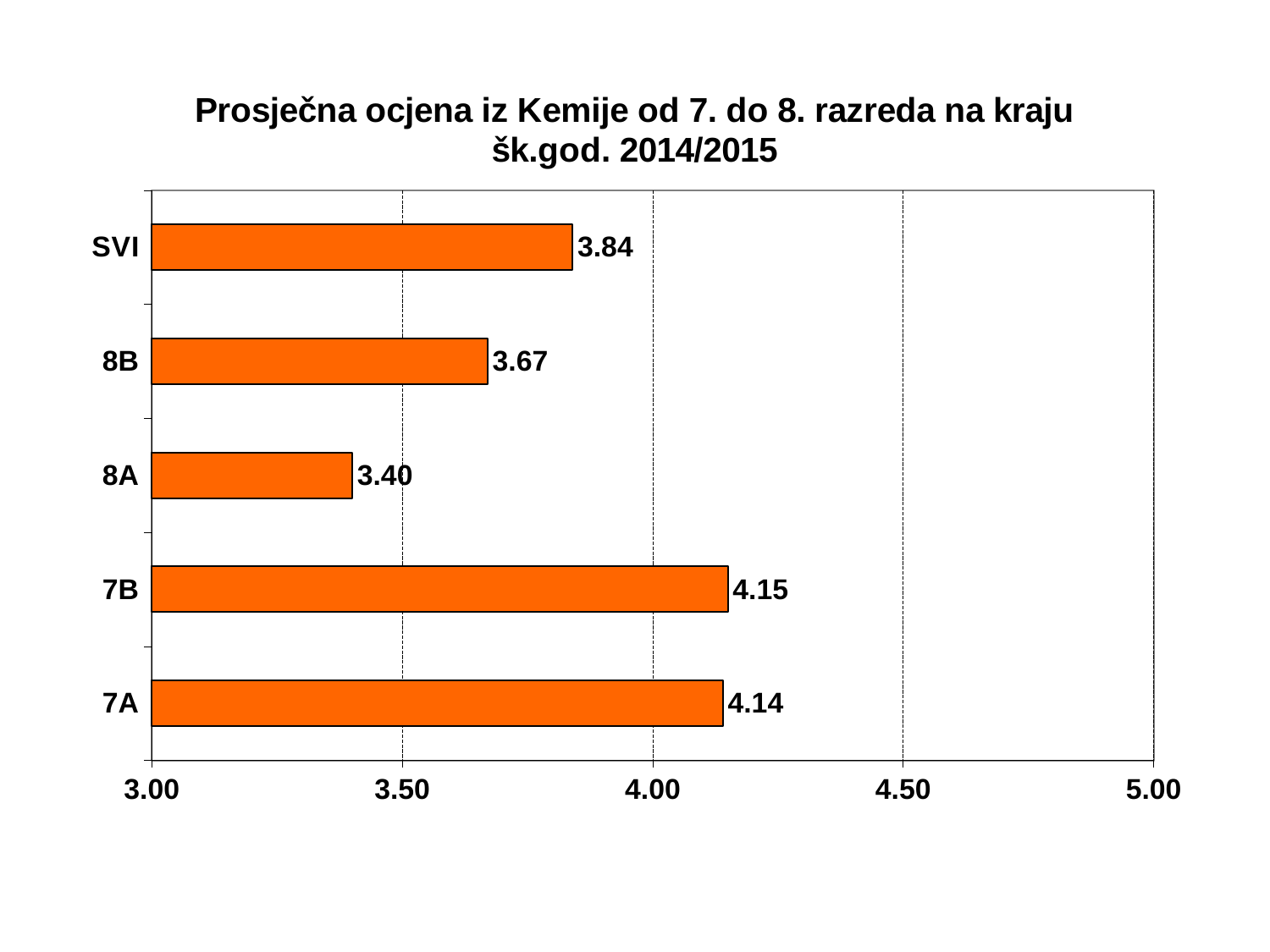
Is the value for 8B greater or less than 3.50? greater What is the average Chemistry grade for 7A? 4.14 What is the difference between the values for 7B and SVI? 0.31 How many categories are shown on the chart? 5 What is the title of the chart? Prosječna ocjena iz Kemije od 7. do 8. razreda na kraju šk.god. 2014/2015 Which category has the highest value? 7B What kind of chart is shown on the slide? Bar chart Which is larger, the value for 8B or the value for 8A? 8B What is the value shown for 8A? 3.40 What is the value shown for SVI? 3.84 What is the difference between the values for 8B and 8A? 0.27 Which category has the lowest value? 8A